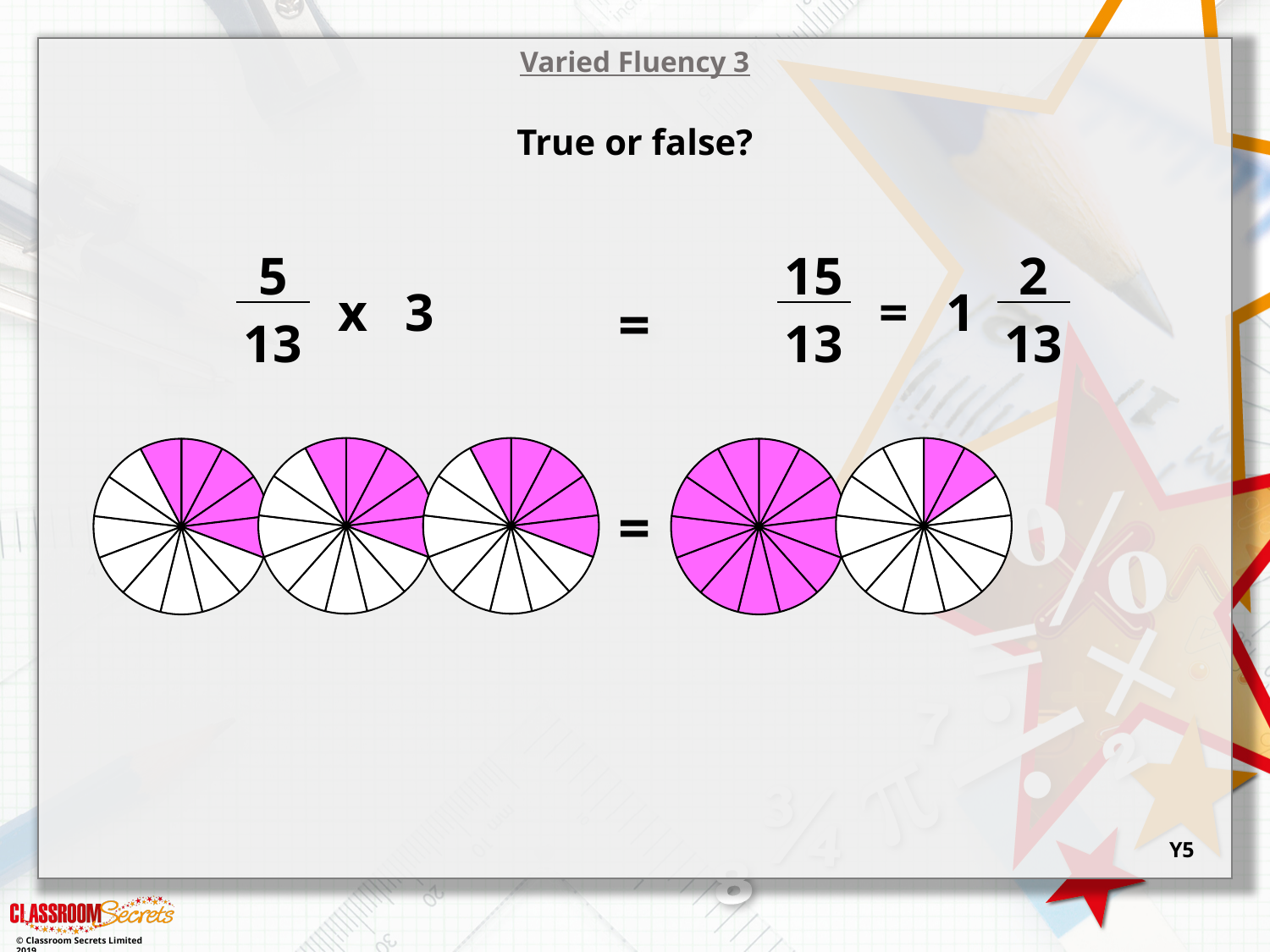
How many equal segments is each circle divided into? 13 What colour are the shaded segments in the circles? pink What fraction does each of the three circles on the left represent, as written above them? 5/13 What is the total number of pink segments across the two circles on the right? 15 How many circles are shown to the right of the equals sign in the diagram? 2 What is the total number of pink segments across the three circles on the left? 15 How many segments are shaded pink in the first circle to the right of the equals sign? 13 How many circles are shown to the left of the equals sign in the diagram? 3 How many segments are shaded pink in the first circle on the left? 5 How many segments are shaded pink in the last circle on the right? 2 Which circle has more pink segments: the first circle on the left or the last circle on the right? the first circle on the left